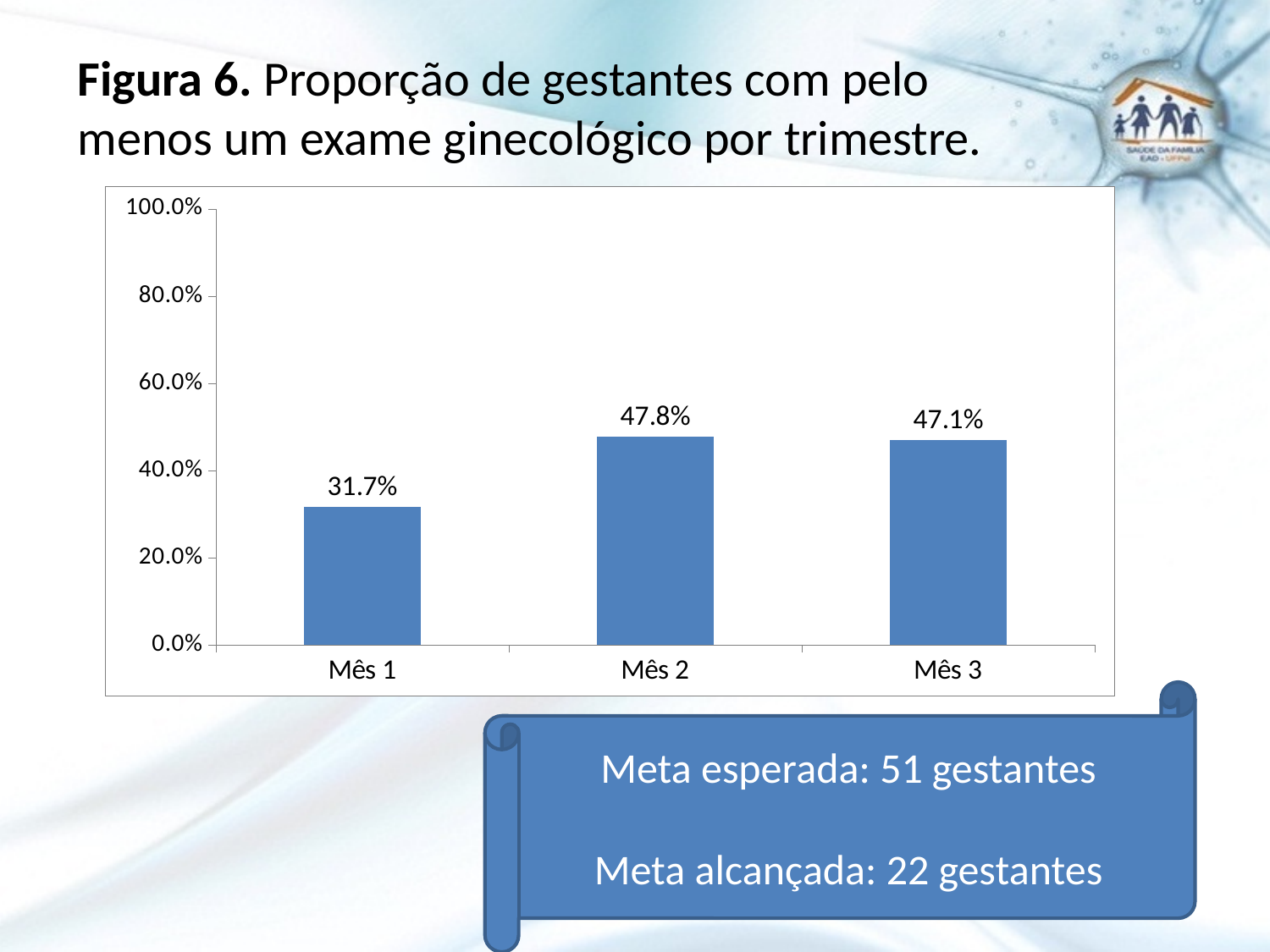
How many months are shown on the x axis? 3 Which month has the highest value? Mês 2 What is the figure number given in the slide title? Figura 6 Which month has the lowest value? Mês 1 What is the value for Mês 1? 31.7% What kind of chart is shown on the slide? bar chart What is the value for Mês 3? 47.1% What is the value for Mês 2? 47.8% Is the value for Mês 1 greater or less than 40.0%? less What is the difference between the values for Mês 2 and Mês 1? 16.1% What is the difference between the values for Mês 2 and Mês 3? 0.7% Which is larger, the value for Mês 1 or the value for Mês 3? Mês 3